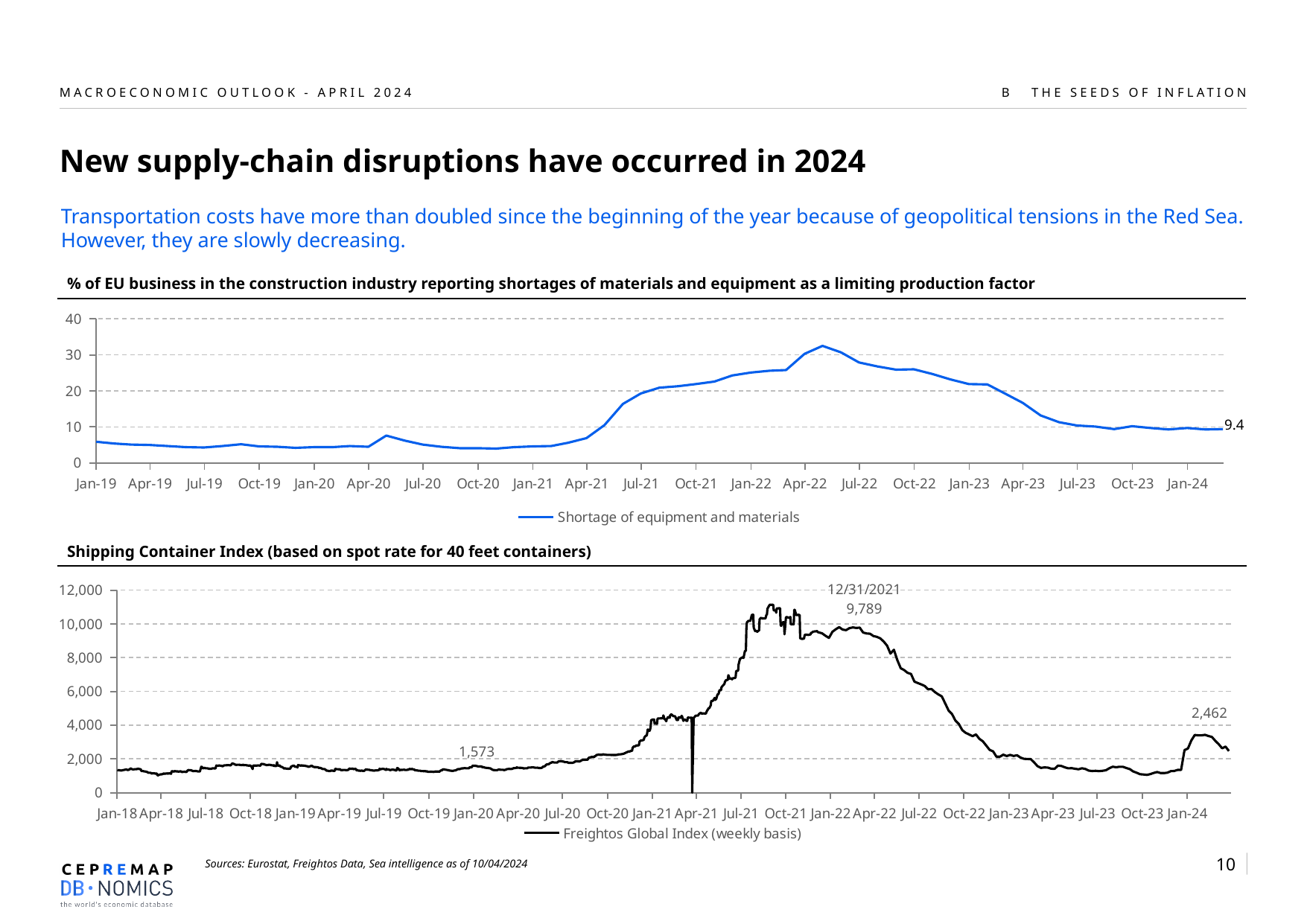
On the top chart, what series name does the legend show? Shortage of equipment and materials On the top chart, is the value for Apr-22 greater or less than 30? greater On the bottom chart, what is the difference between the labelled value 9,789 and the labelled value 2,462? 7,327 On the bottom chart (Shipping Container Index), what value is labelled on the line around Jan-20? 1,573 On the top chart (% of EU business in the construction industry reporting shortages), what is the latest value shown by the data label at the end of the line? 9.4 On the top chart, is the value for Jan-19 greater or less than 10? less On the bottom chart, which labelled value is larger: the one at 12/31/2021 or the one at the end of the line in 2024? 12/31/2021 (9,789) On the top chart, does the line rise or fall between Jul-22 and Jan-24? fall What type of chart is the top chart showing shortages of equipment and materials? line chart On the bottom chart (Shipping Container Index), what is the value labelled at the end of the line in 2024? 2,462 On the bottom chart (Shipping Container Index), what value is labelled at 12/31/2021? 9,789 On the bottom chart, what series name does the legend show? Freightos Global Index (weekly basis)